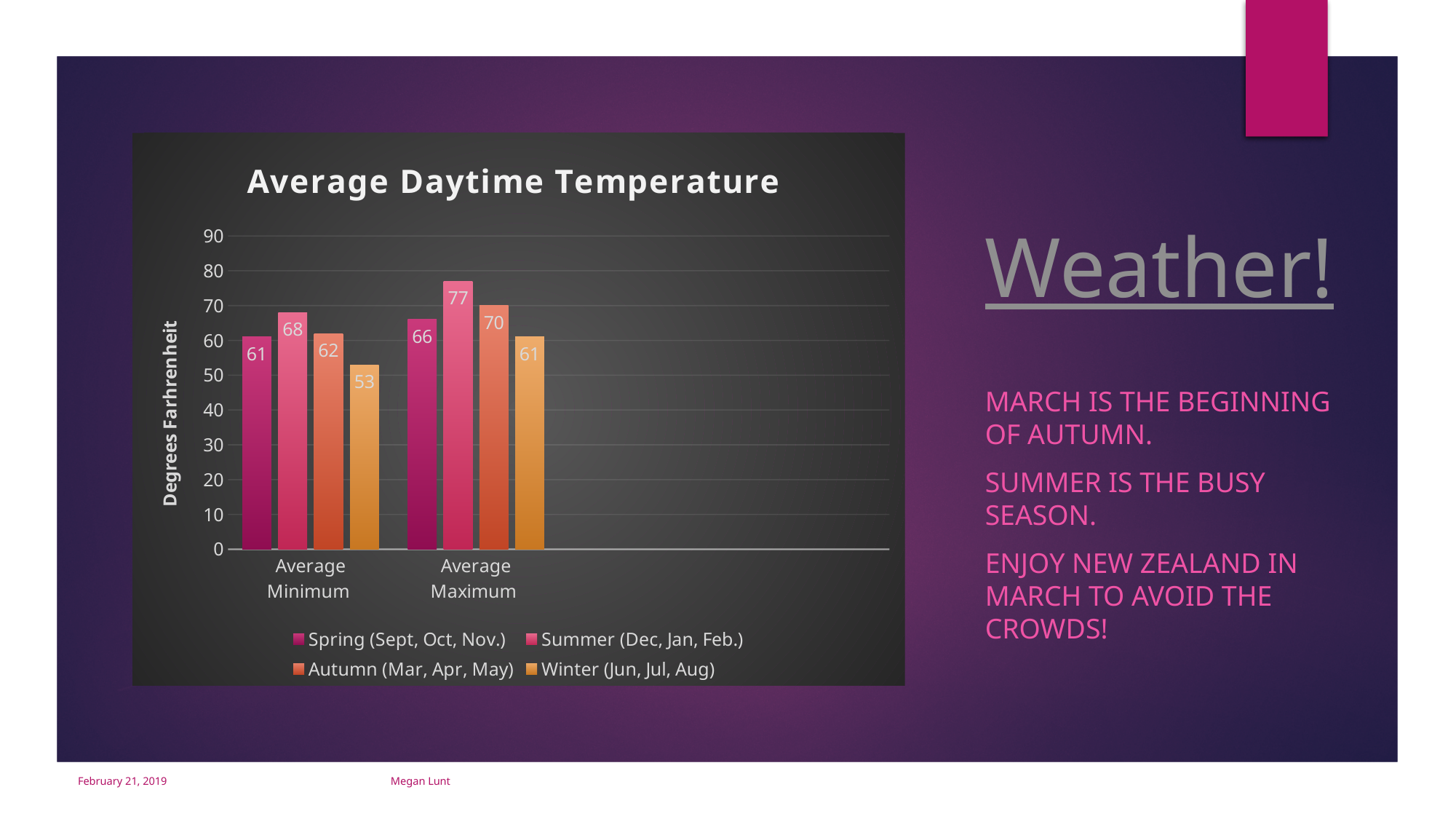
Is the Average Minimum temperature for Winter (Jun, Jul, Aug) greater or less than 60? less What is the Average Maximum temperature for Winter (Jun, Jul, Aug)? 61 How many series does the legend list? 4 What is the Average Maximum temperature for Spring (Sept, Oct, Nov.)? 66 What is the Average Minimum temperature for Summer (Dec, Jan, Feb.)? 68 How many categories are shown on the x axis? 2 Which is larger: the Average Minimum for Summer (Dec, Jan, Feb.) or the Average Maximum for Spring (Sept, Oct, Nov.)? Average Minimum for Summer (Dec, Jan, Feb.) What kind of chart is shown on the slide? bar chart Which season has the lowest Average Minimum temperature? Winter (Jun, Jul, Aug) Which season has the highest Average Maximum temperature? Summer (Dec, Jan, Feb.) What is the difference between the Average Maximum and Average Minimum temperatures for Autumn (Mar, Apr, May)? 8 What is the title of the chart? Average Daytime Temperature